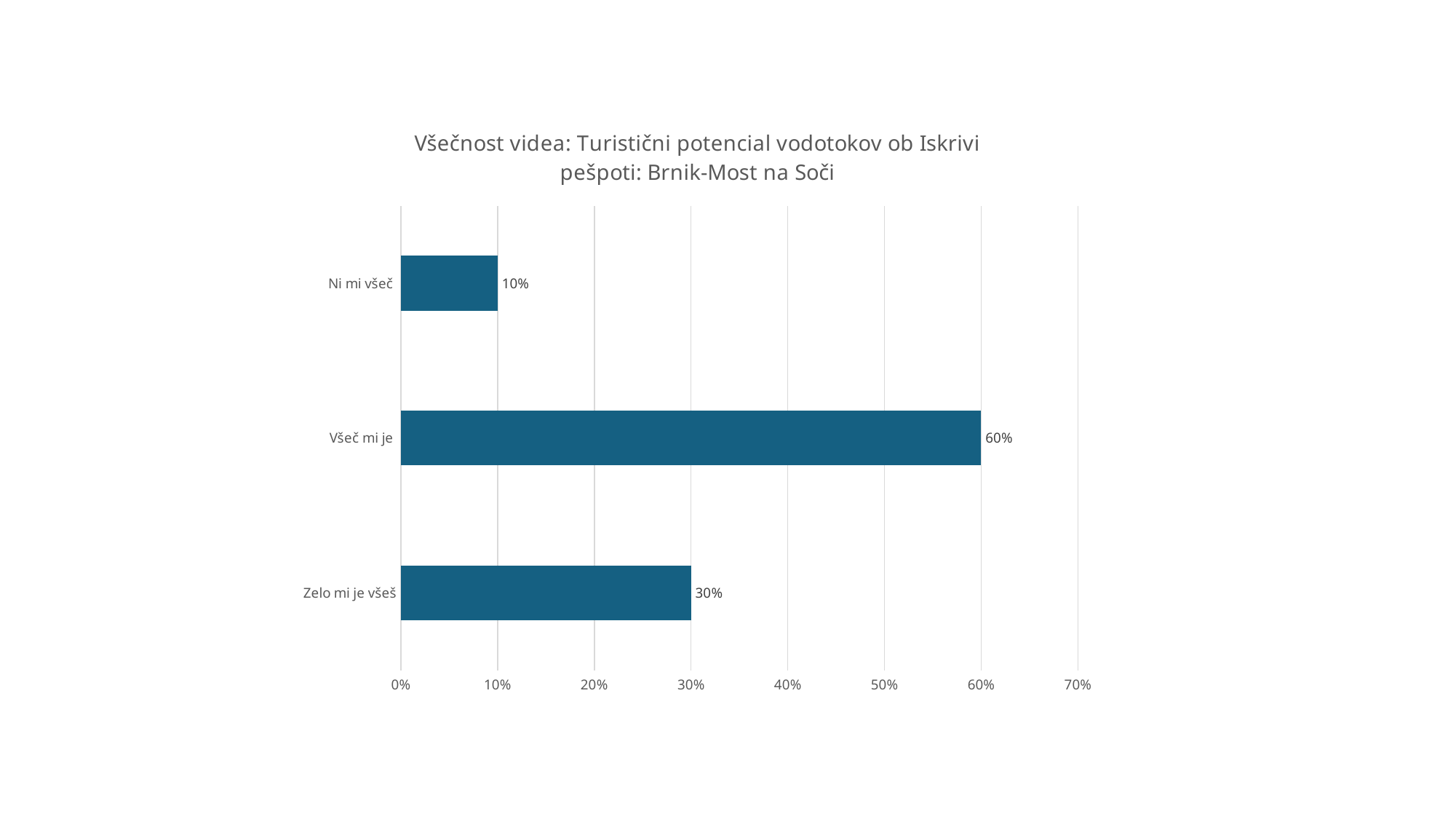
Which is larger, the value for "Zelo mi je všeš" or the value for "Ni mi všeč"? Zelo mi je všeš What is the value for "Ni mi všeč"? 10% What is the value for "Všeč mi je"? 60% Is the value for "Všeč mi je" greater or less than 50%? greater What is the value for "Zelo mi je všeš"? 30% What is the title of the chart? Všečnost videa: Turistični potencial vodotokov ob Iskrivi pešpoti: Brnik-Most na Soči Which category has the lowest value? Ni mi všeč What is the difference between the values for "Zelo mi je všeš" and "Ni mi všeč"? 20% Which category has the highest value? Všeč mi je What is the difference between the values for "Všeč mi je" and "Zelo mi je všeš"? 30% How many categories are shown in the chart? 3 What kind of chart is shown on the slide? bar chart